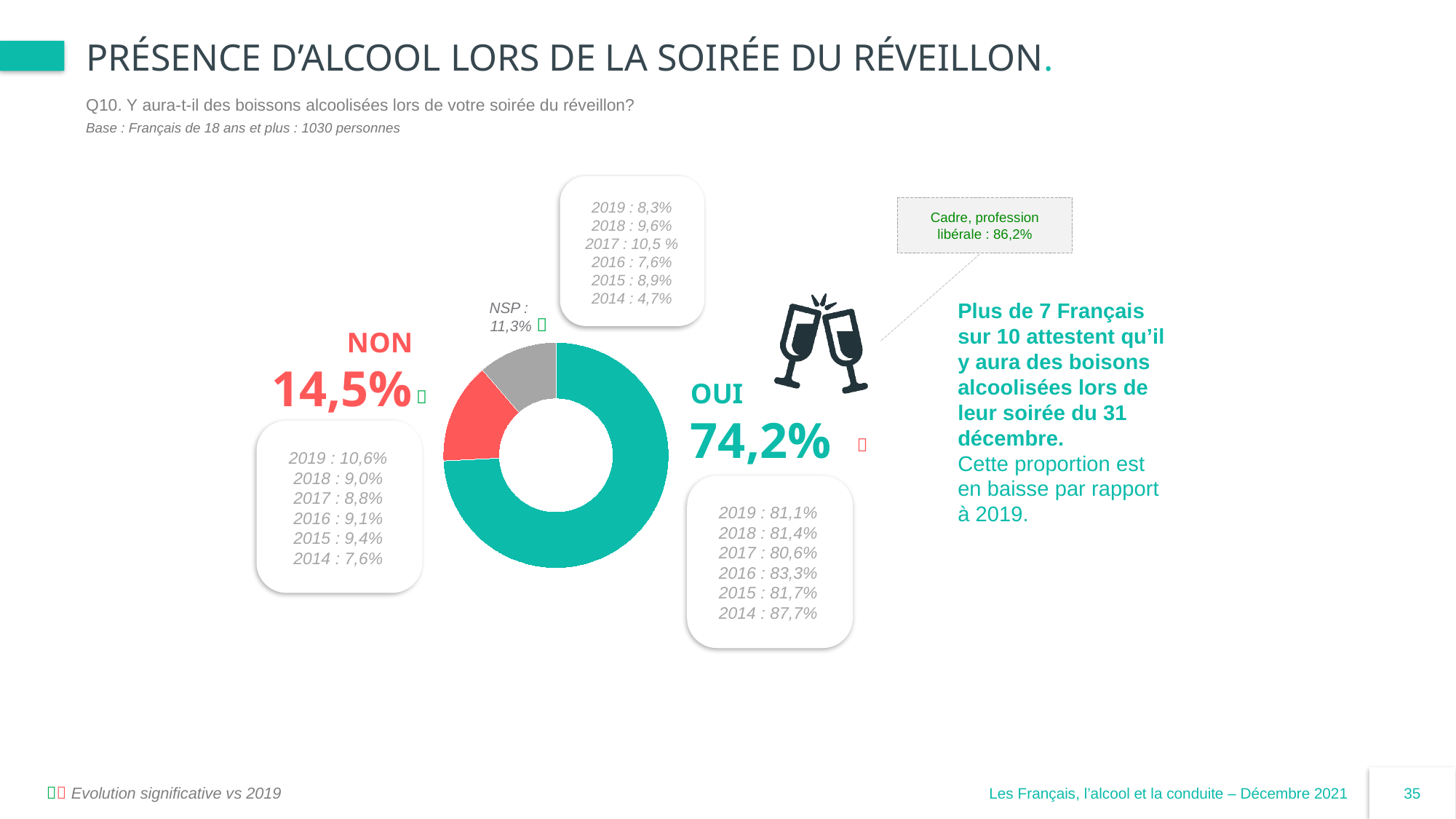
How many slices does the donut chart have? 3 Which slice of the donut chart is the smallest? NSP What is the value for NSP in the donut chart? 11,3% Which slice of the donut chart is the largest? OUI What colour is the OUI slice in the donut chart? Teal (green) Which is larger, the NON slice or the NSP slice? NON According to the box next to the OUI slice, what was the OUI value in 2019? 81,1% What is the difference between the OUI and NON values? 59,7 points What is the value for OUI in the donut chart? 74,2% What kind of chart is shown on the slide? Pie chart (donut) What is the value for NON in the donut chart? 14,5% According to the box next to the NON slice, what was the NON value in 2014? 7,6%